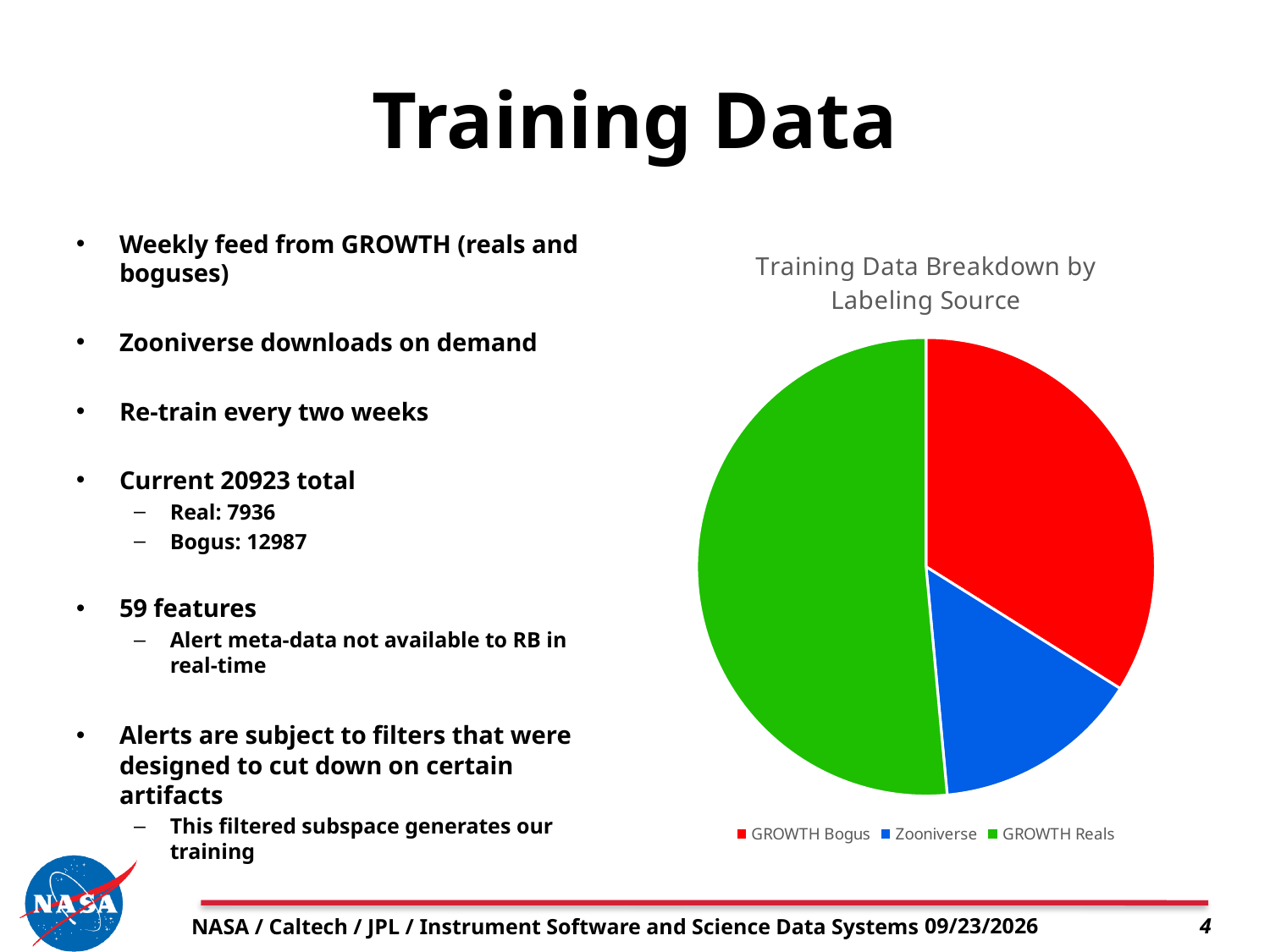
What is the title of the chart? Training Data Breakdown by Labeling Source Which labeling source has the largest slice of the pie? GROWTH Reals How many slices does the pie chart have? 3 Which slice is larger, GROWTH Reals or Zooniverse? GROWTH Reals What kind of chart is shown on the slide? pie chart Which slice is larger, GROWTH Bogus or Zooniverse? GROWTH Bogus How many entries does the chart legend list? 3 Which labeling source has the smallest slice of the pie? Zooniverse What colour is the GROWTH Bogus slice in the pie chart? red